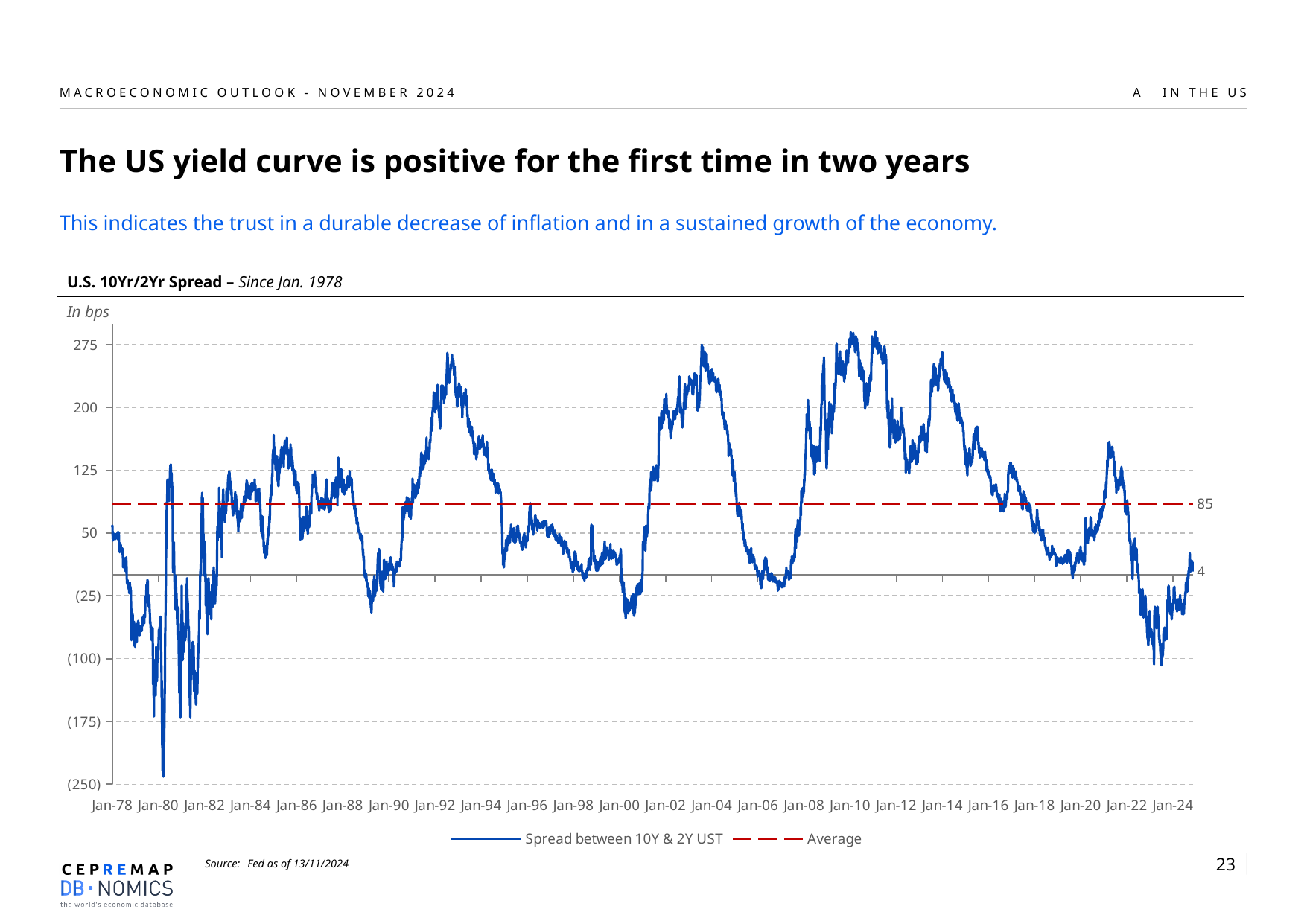
Is the value of the spread around Jan-06 greater or less than 50? less What unit is indicated for the values on the chart? In bps What is the difference between the Average (85) and the latest spread value (4)? 81 What is the title of the chart? U.S. 10Yr/2Yr Spread – Since Jan. 1978 Which is larger, the Average line value or the latest spread value? Average What is the value of the Average line shown on the chart? 85 What kind of chart is shown on the slide? line chart What is the latest value of the spread between 10Y & 2Y UST labelled at the right end of the chart? 4 Between Jan-08 and Jan-10, does the spread rise or fall? rise Is the peak of the spread around Jan-10 greater or less than 200? greater Is the lowest value of the spread, reached around Jan-80, greater or less than (175)? less How many series does the legend list? 2